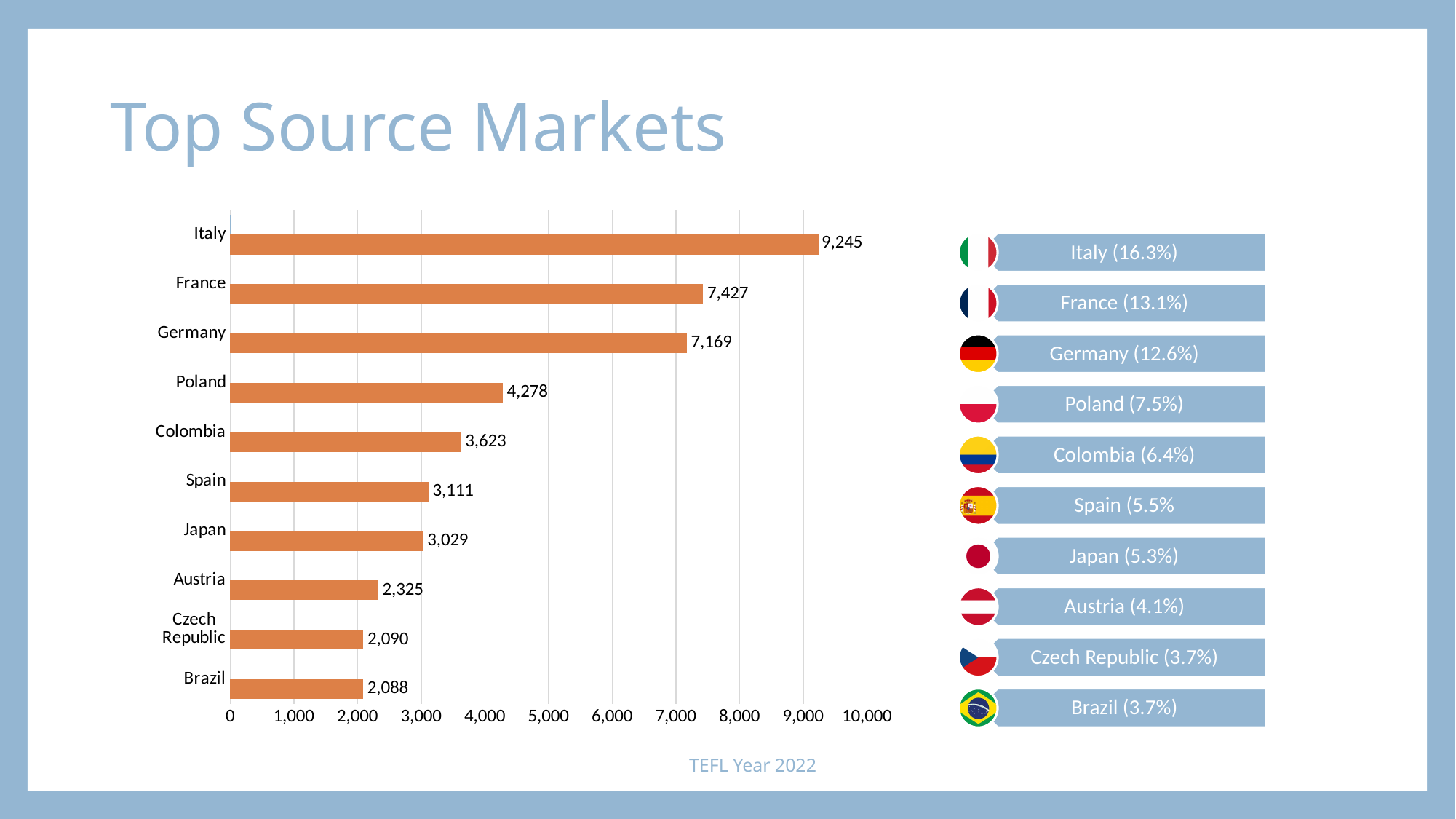
What is the title of the slide? Top Source Markets What is the value for Poland? 4,278 Is the value for Austria greater or less than 2,000? greater Which country has the highest value? Italy Which country has the lowest value? Brazil What is the value for Japan? 3,029 What is the difference between the values for Italy and Brazil? 7,157 Which is larger, the value for Colombia or the value for Spain? Colombia What kind of chart is shown on the slide? bar chart What is the value for Italy? 9,245 What is the difference between the values for France and Germany? 258 How many countries are shown in the chart? 10